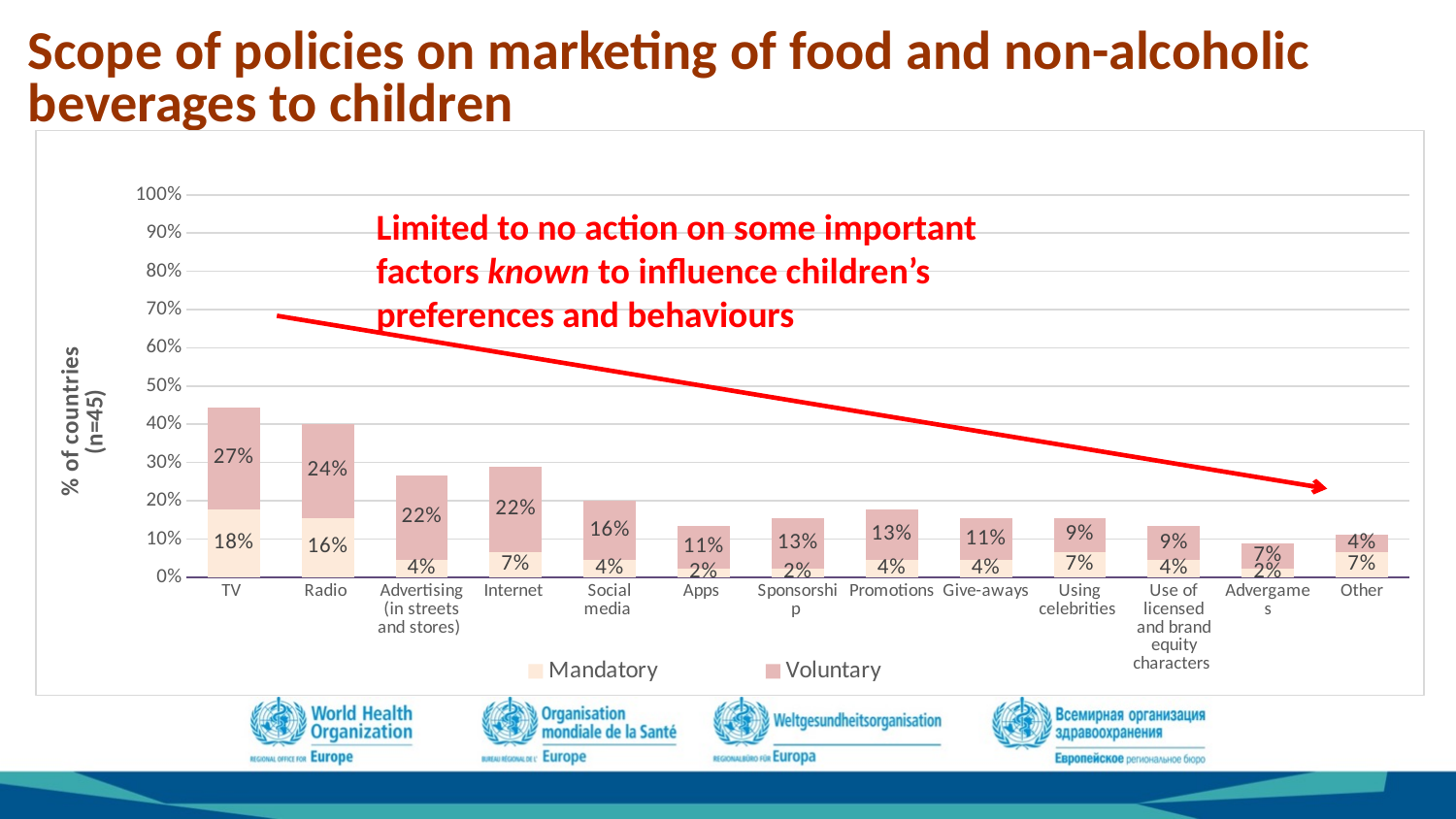
What is the y-axis label of the chart? % of countries (n=45) What is the Voluntary value for Advergames? 7% What type of chart is shown on the slide? stacked bar chart How many categories are shown on the x axis? 13 Which category has the highest Voluntary value? TV What is the Mandatory value for Internet? 7% Which is larger, the Mandatory value for Using celebrities or the Mandatory value for Give-aways? Using celebrities What is the total of the stacked bar for TV? 45% What is the Voluntary value for Radio? 24% How many series does the legend list? 2 What is the difference between the Voluntary values for Social media and Apps? 5% What is the Mandatory value for TV? 18%